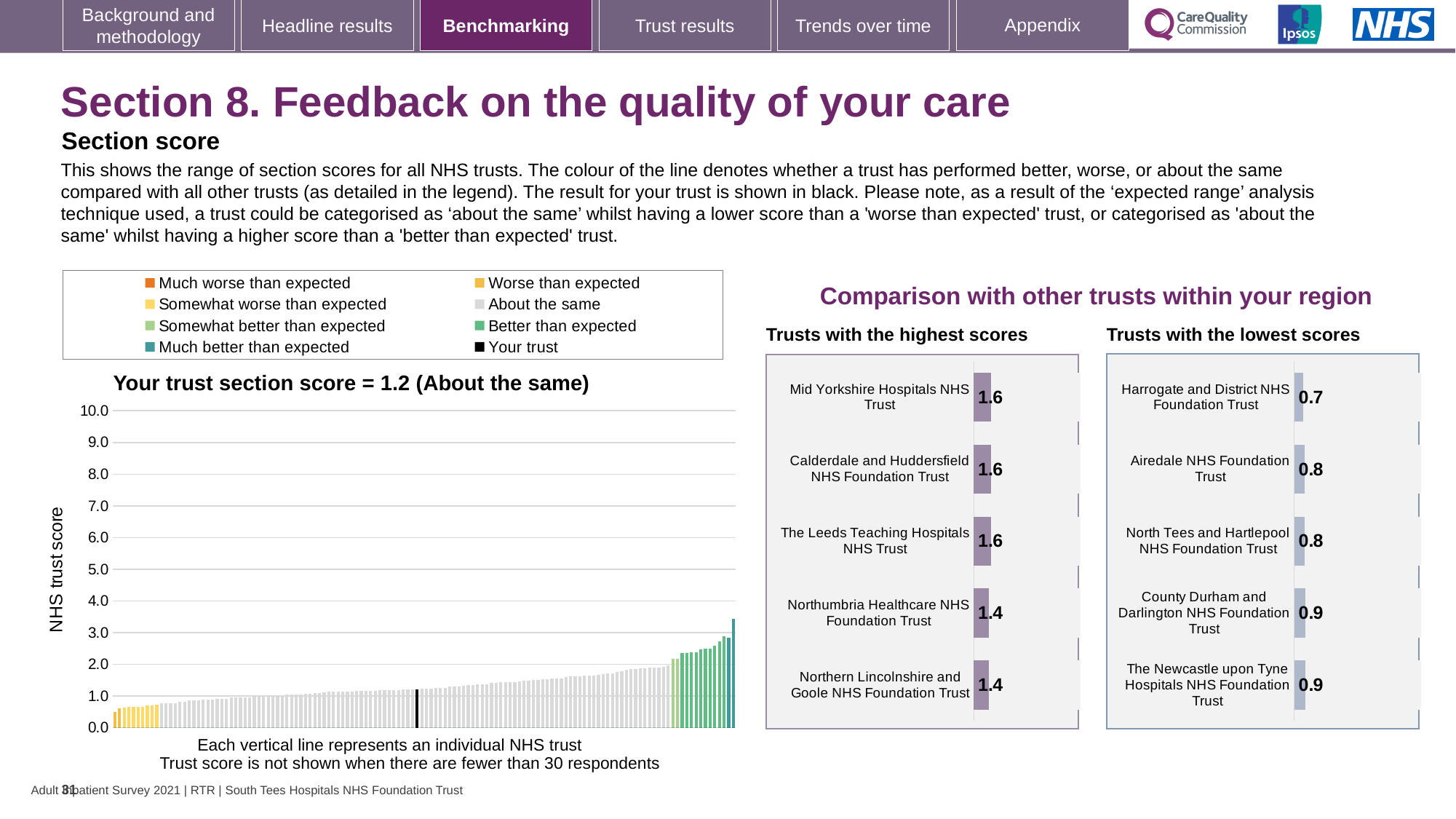
In the 'Your trust section score' chart, do the bars rise or fall from left to right? rise In the 'Trusts with the lowest scores' chart, what is the score for Airedale NHS Foundation Trust? 0.8 In the 'Trusts with the lowest scores' chart, which trust has the lowest score? Harrogate and District NHS Foundation Trust In the 'Trusts with the highest scores' chart, what is the difference between the scores of Mid Yorkshire Hospitals NHS Trust and Northumbria Healthcare NHS Foundation Trust? 0.2 How many entries does the legend above the 'Your trust section score' chart list? 8 In the 'Trusts with the highest scores' chart, what is the score for Northumbria Healthcare NHS Foundation Trust? 1.4 What kind of chart is the 'Your trust section score' chart? bar chart In the 'Trusts with the highest scores' chart, how many trusts are shown? 5 In the 'Trusts with the lowest scores' chart, what is the difference between the scores of The Newcastle upon Tyne Hospitals NHS Foundation Trust and Harrogate and District NHS Foundation Trust? 0.2 In the 'Your trust section score' chart, what is the section score for your trust? 1.2 In the 'Your trust section score' chart, is the value of the tallest bar greater or less than 4.0? less In the 'Trusts with the highest scores' chart, which is larger: the score for The Leeds Teaching Hospitals NHS Trust or for Northern Lincolnshire and Goole NHS Foundation Trust? The Leeds Teaching Hospitals NHS Trust